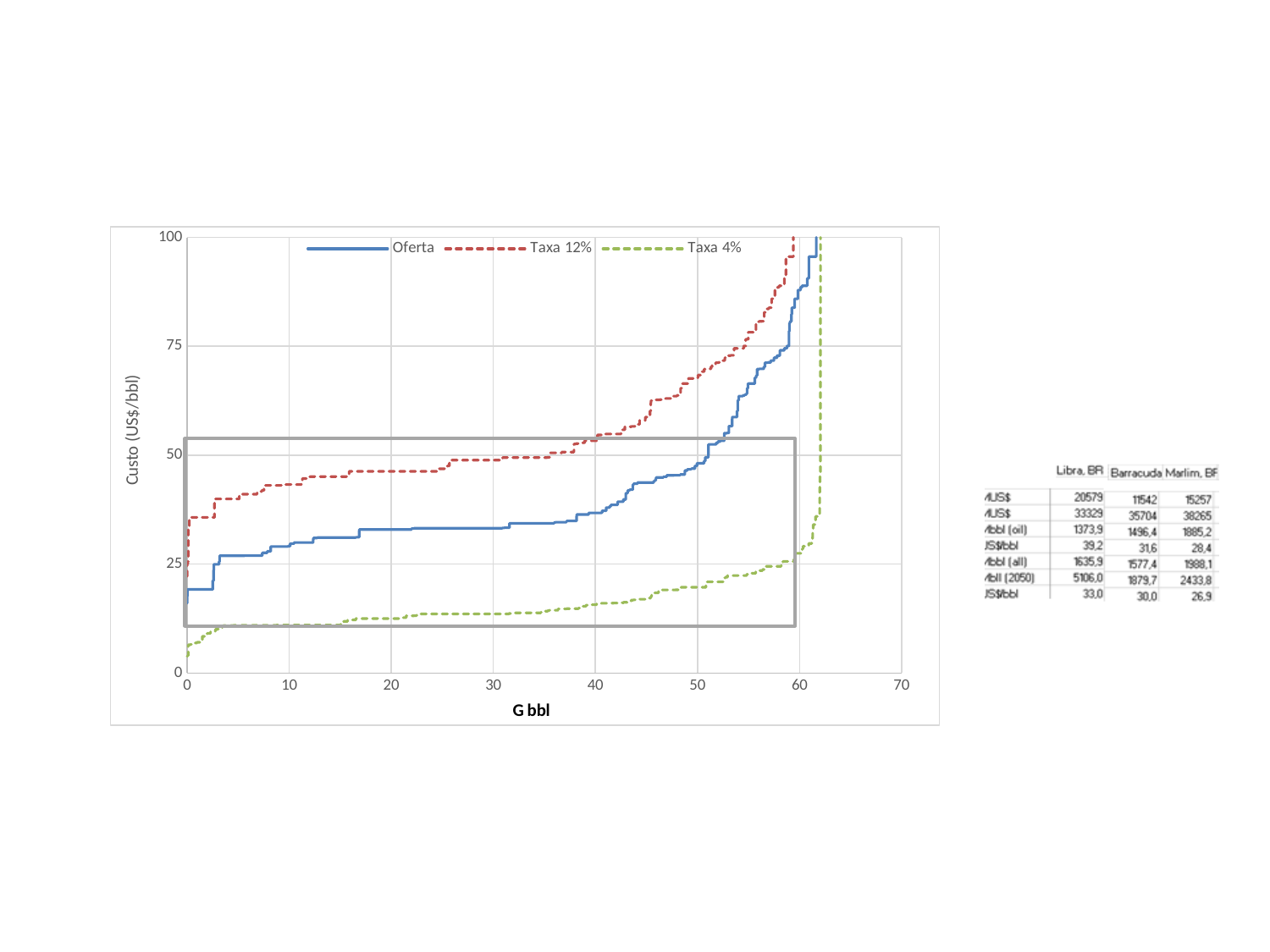
How many series does the chart legend list? 3 Is the value of the Taxa 12% series at 10 G bbl greater or less than 50? less At 20 G bbl, which series has the larger value, Taxa 12% or Oferta? Taxa 12% At 40 G bbl, which series has the larger value, Oferta or Taxa 4%? Oferta What is the title of the chart's vertical axis? Custo (US$/bbl) Which series lies lowest on the chart across most of the x-axis range? Taxa 4% Is the value of the Taxa 4% series at 30 G bbl greater or less than 25? less What kind of chart is shown on the slide? line chart Which series lies highest on the chart across most of the x-axis range? Taxa 12% Is the value of the Oferta series at 30 G bbl greater or less than 25? greater What are the series names listed in the chart legend? Oferta, Taxa 12%, Taxa 4% Do the values of the Oferta series rise or fall as G bbl increases along the x axis? rise